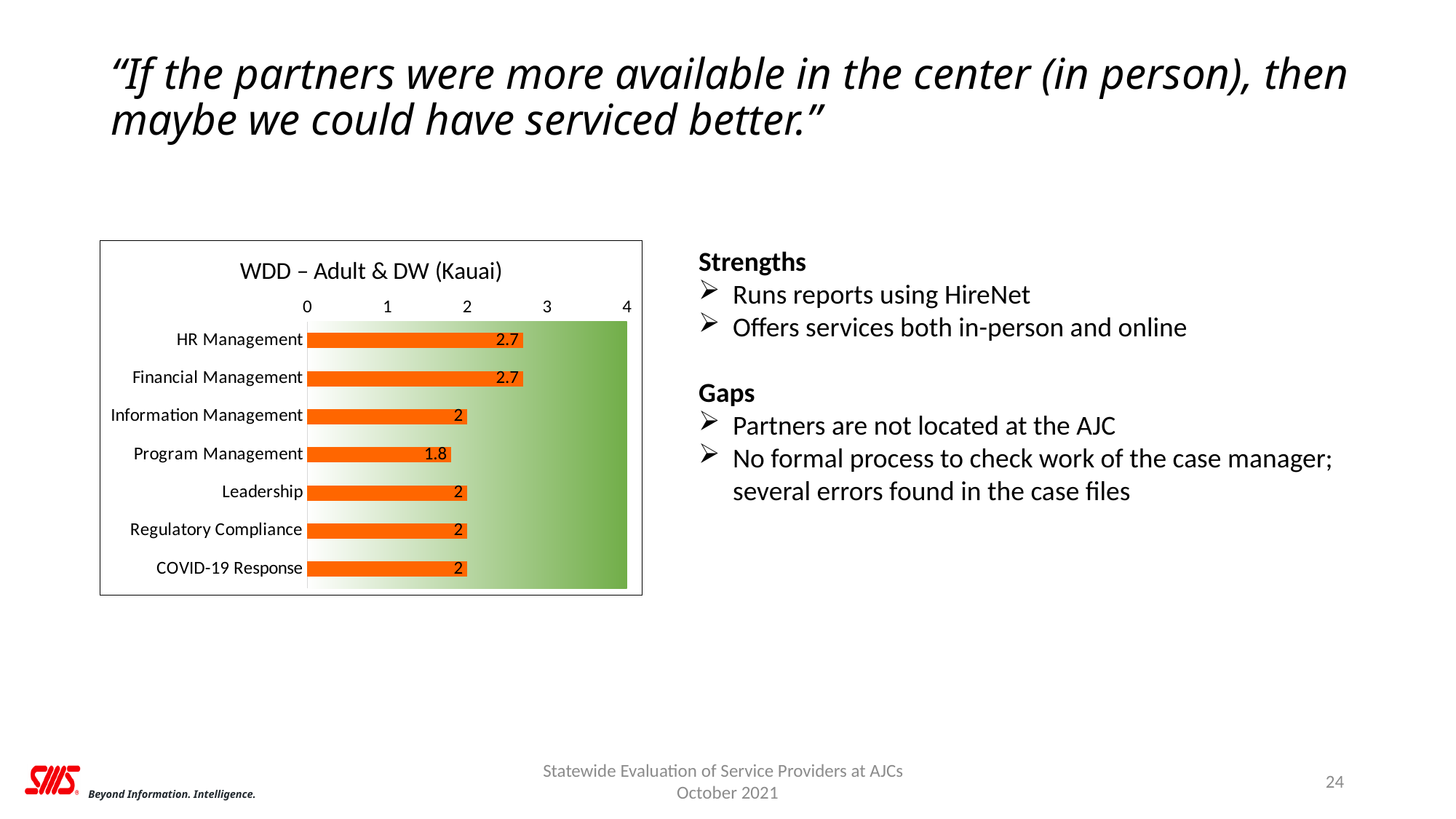
Which category has the lowest value? Program Management What is the difference between the values for HR Management and Program Management? 0.9 Is the value for HR Management greater or less than 3? less What is the value for Program Management? 1.8 What is the difference between the values for Financial Management and Leadership? 0.7 What is the value for Information Management? 2 What kind of chart is shown on the slide? bar chart What is the title of the chart? WDD – Adult & DW (Kauai) What is the value for HR Management? 2.7 Which is larger, the value for Financial Management or the value for Regulatory Compliance? Financial Management How many categories are shown in the chart? 7 What is the value for COVID-19 Response? 2